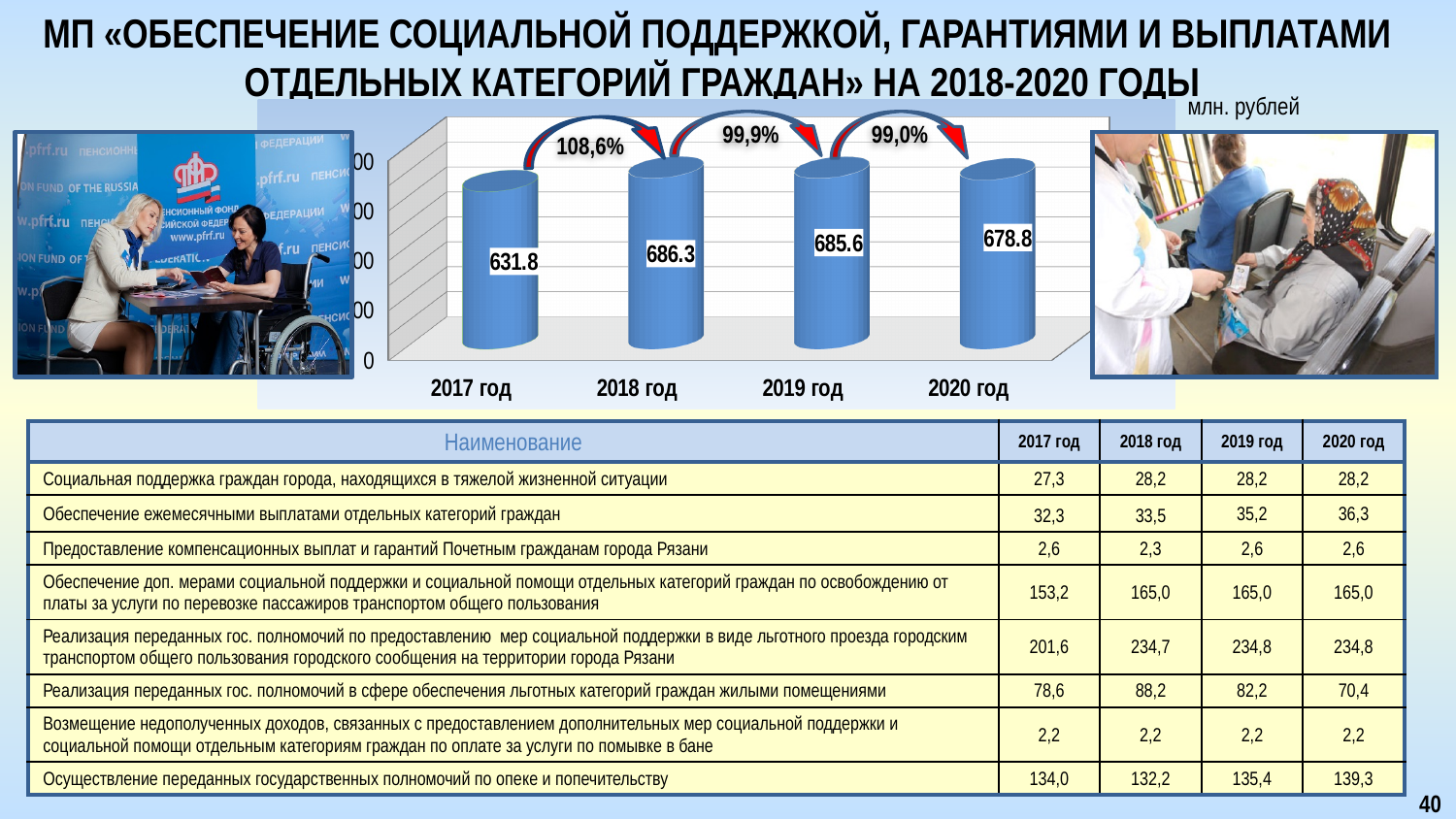
What kind of chart is shown on the slide? Bar chart What percentage is shown above the arrow between 2017 год and 2018 год? 108,6% What is the value for 2017 год in the chart? 631.8 How many years are shown on the x axis of the chart? 4 Which year has the lowest value in the chart? 2017 год What is the value for 2020 год in the chart? 678.8 What is the value for 2019 год in the chart? 685.6 What is the difference between the values for 2018 год and 2017 год? 54.5 Which year has the highest value in the chart? 2018 год What is the difference between the values for 2019 год and 2020 год? 6.8 Which is larger, the value for 2017 год or the value for 2020 год? 2020 год What is the value for 2018 год in the chart? 686.3